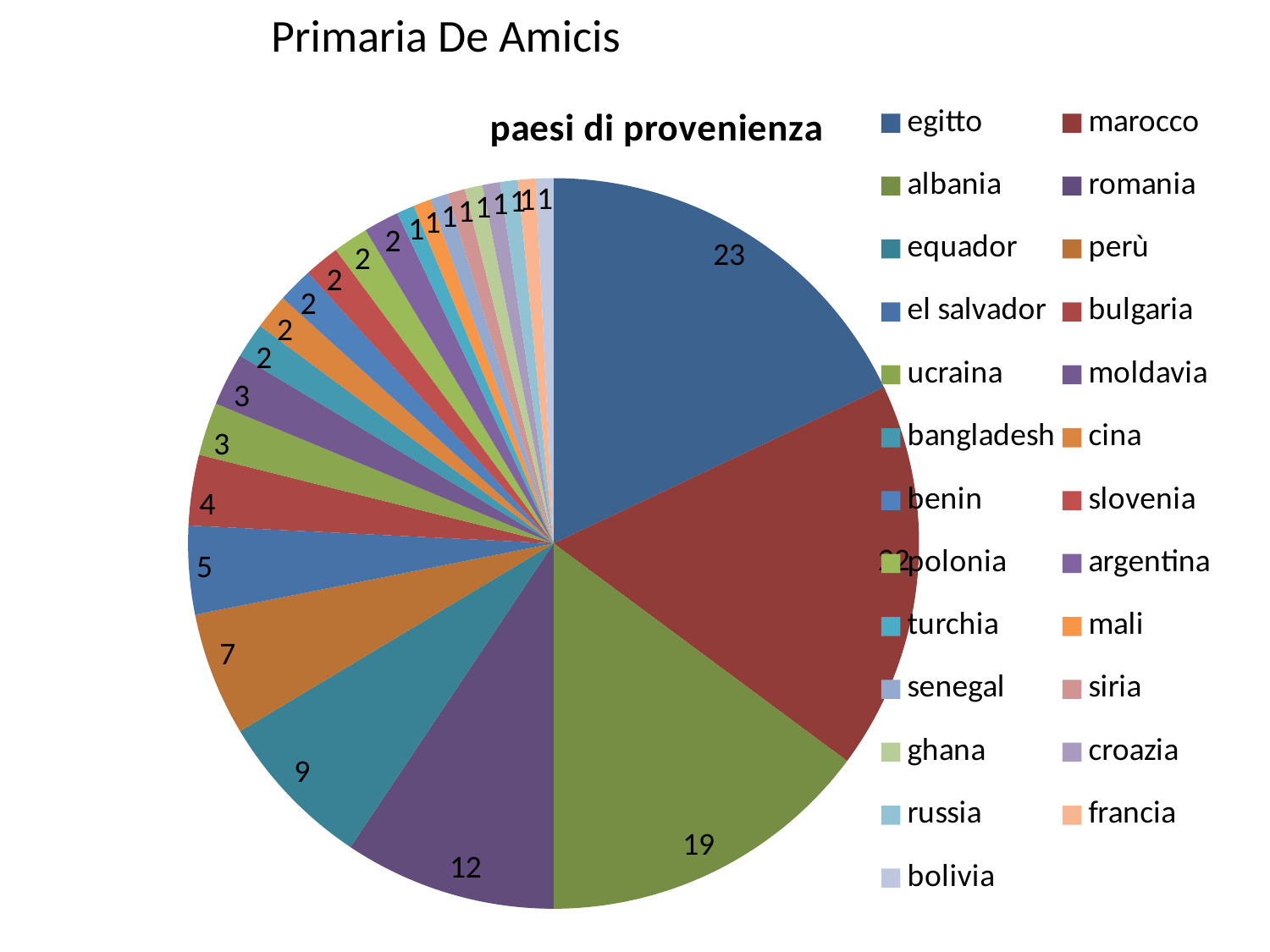
What is the difference between the values for egitto and albania? 4 What kind of chart is shown on the slide? pie chart What is the value for perù? 7 What is the value for albania? 19 What is the title of the chart? paesi di provenienza What is the value for bulgaria? 4 How many countries are listed in the legend? 25 What is the value for romania? 12 Which is larger, the value for romania or the value for equador? romania What is the value for el salvador? 5 What is the value for egitto? 23 What is the value for equador? 9